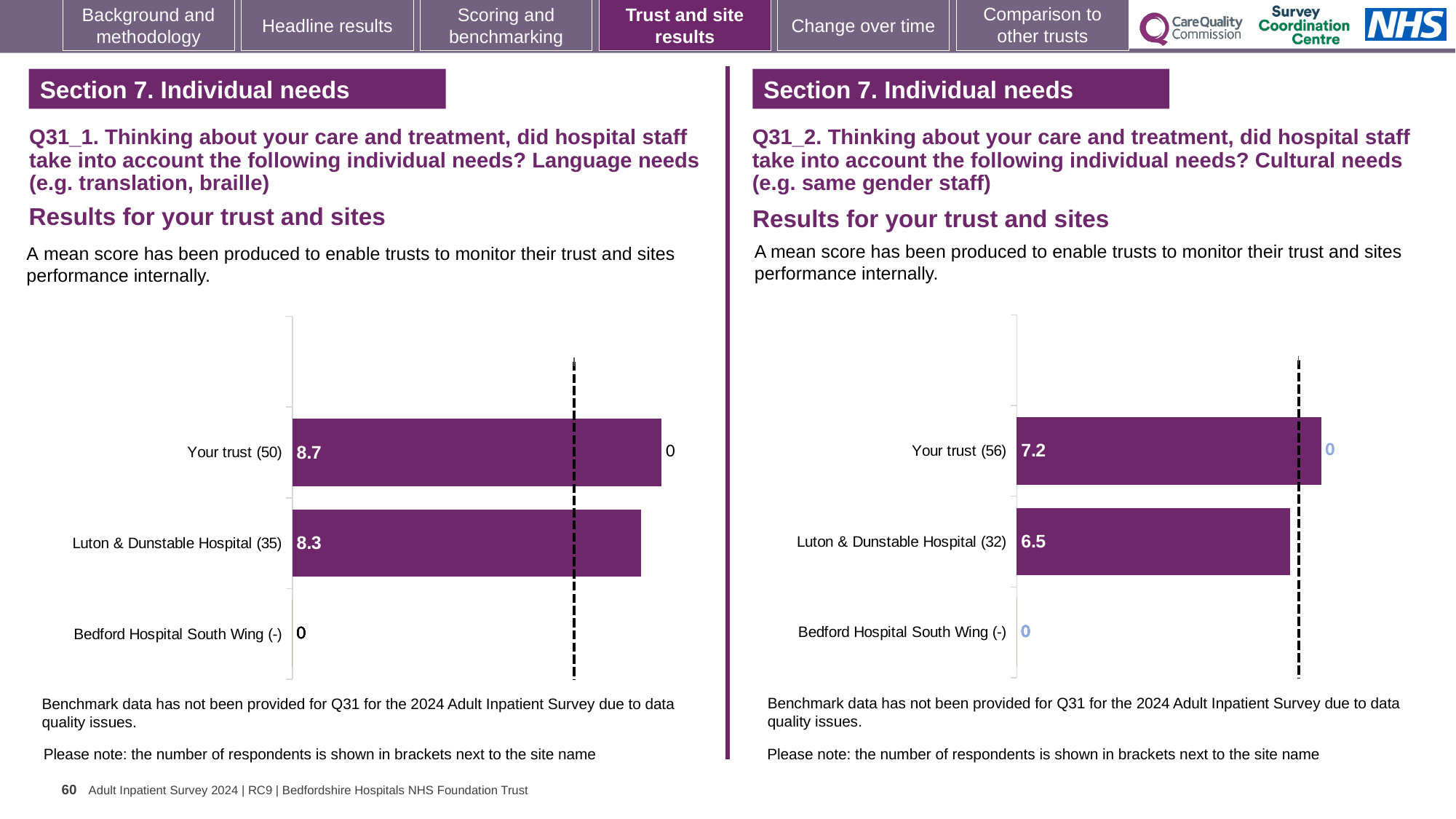
On the right chart (Q31_2, Cultural needs), what is the difference between the scores for Your trust and Luton & Dunstable Hospital? 0.7 On the left chart (Q31_1, Language needs), which category has the highest mean score? Your trust On the left chart (Q31_1, Language needs), what is the difference between the scores for Your trust and Luton & Dunstable Hospital? 0.4 Is the score for Your trust higher on the left chart (Language needs) or the right chart (Cultural needs)? Left chart (Language needs) How many categories are listed on the left chart (Q31_1, Language needs)? 3 On the left chart (Q31_1, Language needs), what is the mean score for Luton & Dunstable Hospital? 8.3 On the right chart (Q31_2, Cultural needs), which category has the highest mean score? Your trust On the right chart (Q31_2, Cultural needs), what is the mean score for Luton & Dunstable Hospital? 6.5 On the left chart (Q31_1, Language needs), what is the mean score for Your trust? 8.7 What type of chart is used on the right side of the slide (Q31_2, Cultural needs)? Bar chart On the left chart (Q31_1, Language needs), how many respondents are shown in brackets for Luton & Dunstable Hospital? 35 On the right chart (Q31_2, Cultural needs), what is the mean score for Your trust? 7.2